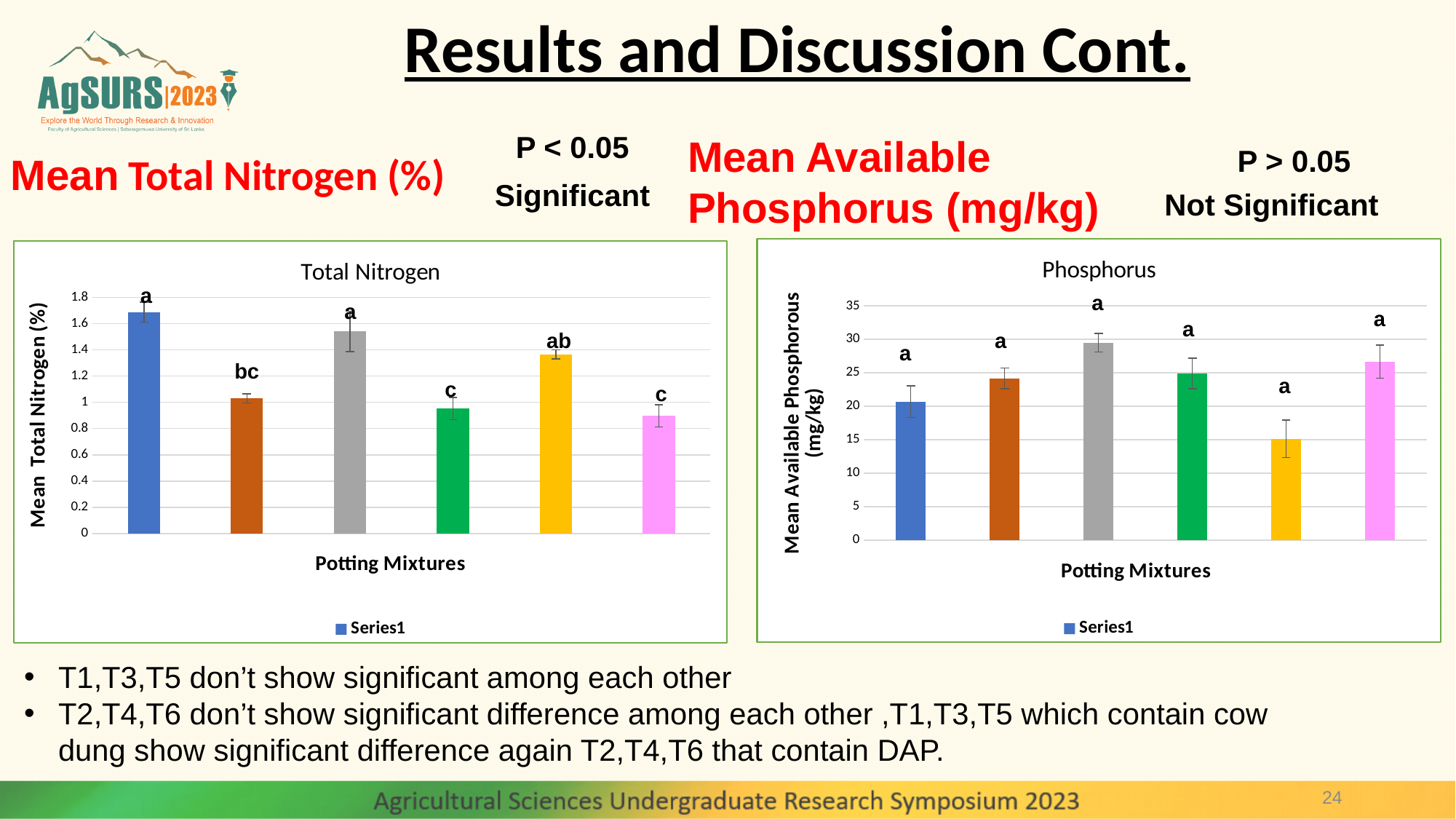
In the Total Nitrogen chart, which bar is the highest? the first (blue) bar In the Phosphorus chart, which bar is the lowest? the fifth (yellow) bar In the Total Nitrogen chart, is the value of the first (blue) bar greater or less than 1.6? greater What is the x-axis label of the Phosphorus chart? Potting Mixtures In the Total Nitrogen chart, is the value of the sixth (pink) bar greater or less than 1? less What type of chart is the Total Nitrogen chart on the left? bar chart In the Phosphorus chart, which bar is the highest? the third (grey) bar In the Phosphorus chart, is the value of the fifth (yellow) bar greater or less than 20? less In the Total Nitrogen chart, how many bars are plotted? 6 In the Total Nitrogen chart, which is larger: the first (blue) bar or the second (orange) bar? the first (blue) bar In the Phosphorus chart, how many series does the legend list? 1